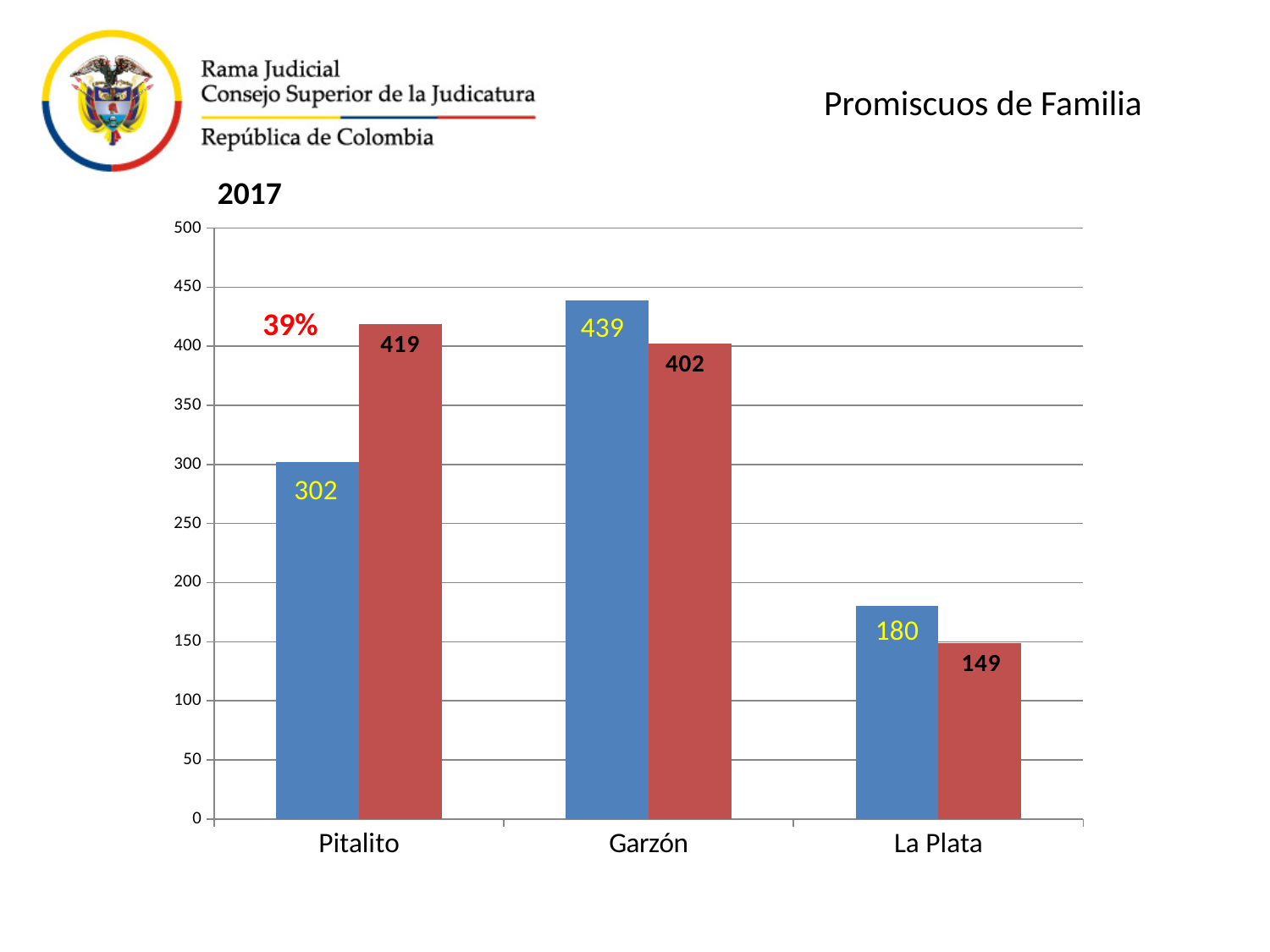
What is the difference between the red bar and the blue bar for Pitalito? 117 Which category has the lowest red bar? La Plata What is the title of the chart? 2017 Which category has the highest blue bar? Garzón For La Plata, which is larger, the blue bar or the red bar? the blue bar What percentage is printed in red above the Pitalito bars? 39% How many categories are shown on the x axis? 3 What is the value of the blue bar for Pitalito? 302 What is the value of the red bar for Garzón? 402 What kind of chart is shown on the slide? bar chart What is the difference between the blue bar and the red bar for Garzón? 37 What is the value of the red bar for La Plata? 149